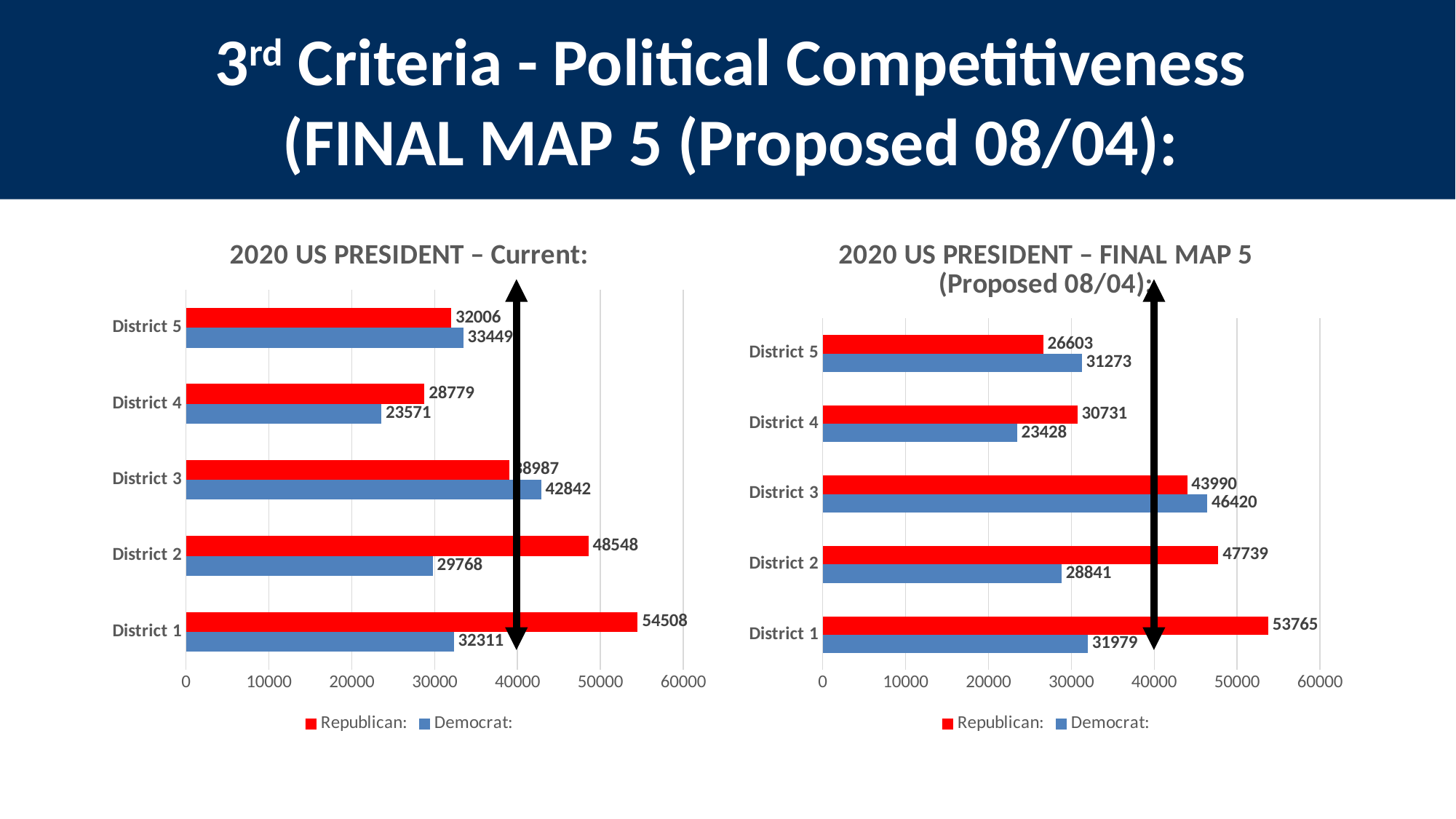
How many districts are shown in the '2020 US PRESIDENT – FINAL MAP 5 (Proposed 08/04)' chart? 5 In the '2020 US PRESIDENT – Current' chart, what is the difference between the Democrat and Republican values for District 5? 1443 What kind of chart is the '2020 US PRESIDENT – Current' chart? Bar chart In the '2020 US PRESIDENT – Current' chart, is the Republican value for District 2 greater or less than 40000? greater In the '2020 US PRESIDENT – Current' chart, what is the Republican value for District 1? 54508 In the '2020 US PRESIDENT – FINAL MAP 5 (Proposed 08/04)' chart, what is the Democrat value for District 5? 31273 In the '2020 US PRESIDENT – FINAL MAP 5 (Proposed 08/04)' chart, what is the difference between the Republican and Democrat values for District 1? 21786 In the '2020 US PRESIDENT – Current' chart, which district has the highest Republican value? District 1 In the '2020 US PRESIDENT – FINAL MAP 5 (Proposed 08/04)' chart, which is larger for District 3, the Republican or the Democrat value? Democrat In the '2020 US PRESIDENT – FINAL MAP 5 (Proposed 08/04)' chart, which district has the lowest Democrat value? District 4 In the '2020 US PRESIDENT – Current' chart, what is the Democrat value for District 3? 42842 In the '2020 US PRESIDENT – FINAL MAP 5 (Proposed 08/04)' chart, what is the Republican value for District 2? 47739